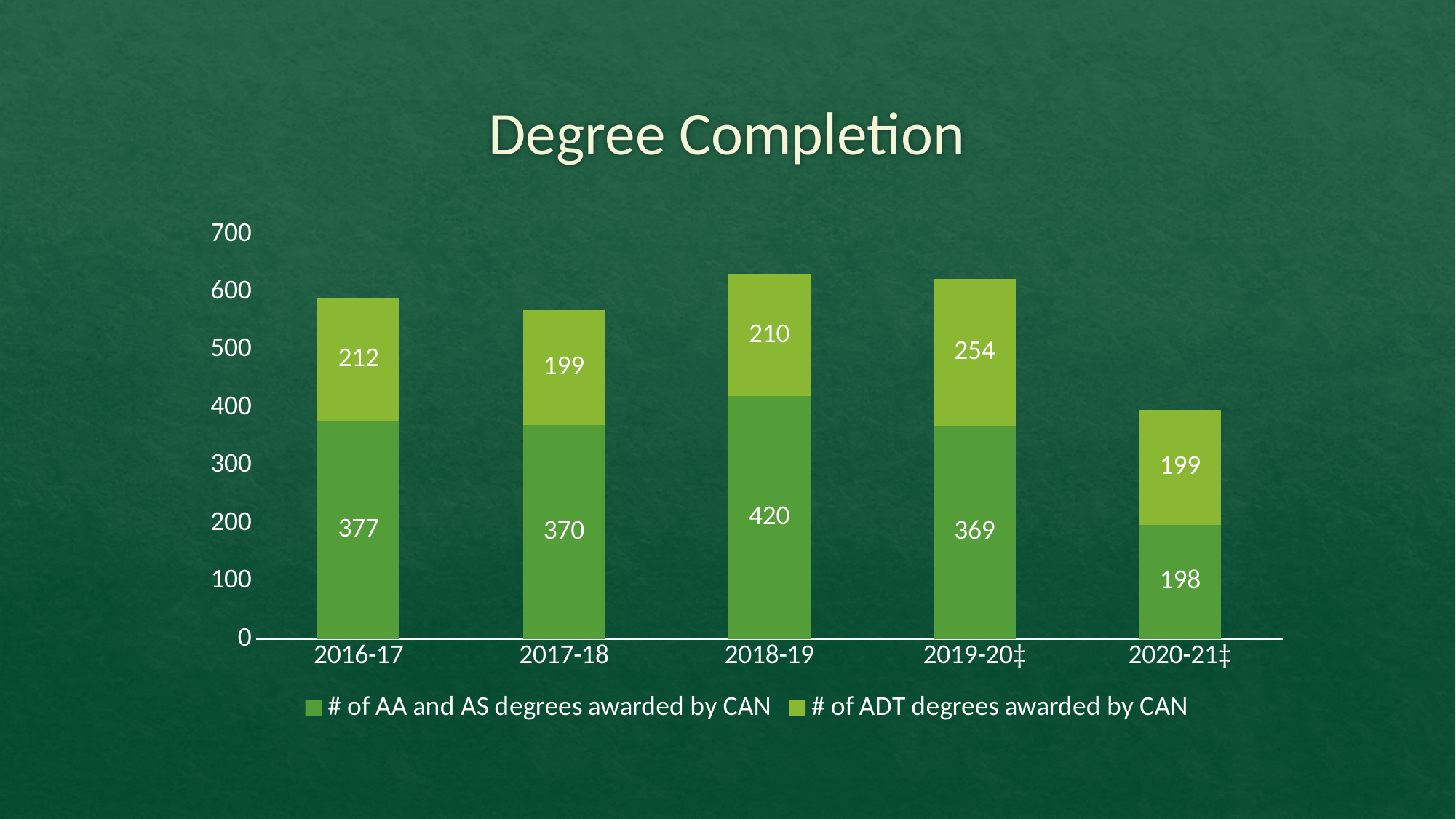
How many series does the legend list? 2 What type of chart is shown on the slide? Stacked bar chart What is the total number of degrees awarded by CAN in 2019-20‡ (both series combined)? 623 Which year has the highest number of ADT degrees awarded by CAN? 2019-20‡ Which year has the lowest number of AA and AS degrees awarded by CAN? 2020-21‡ What is the number of ADT degrees awarded by CAN in 2019-20‡? 254 How many years are shown on the x axis? 5 What is the number of AA and AS degrees awarded by CAN in 2020-21‡? 198 What is the number of AA and AS degrees awarded by CAN in 2018-19? 420 What is the total number of degrees awarded by CAN in 2020-21‡ (both series combined)? 397 Which is larger: the number of ADT degrees awarded in 2016-17 or in 2017-18? 2016-17 What is the difference between the number of AA and AS degrees awarded in 2018-19 and in 2017-18? 50